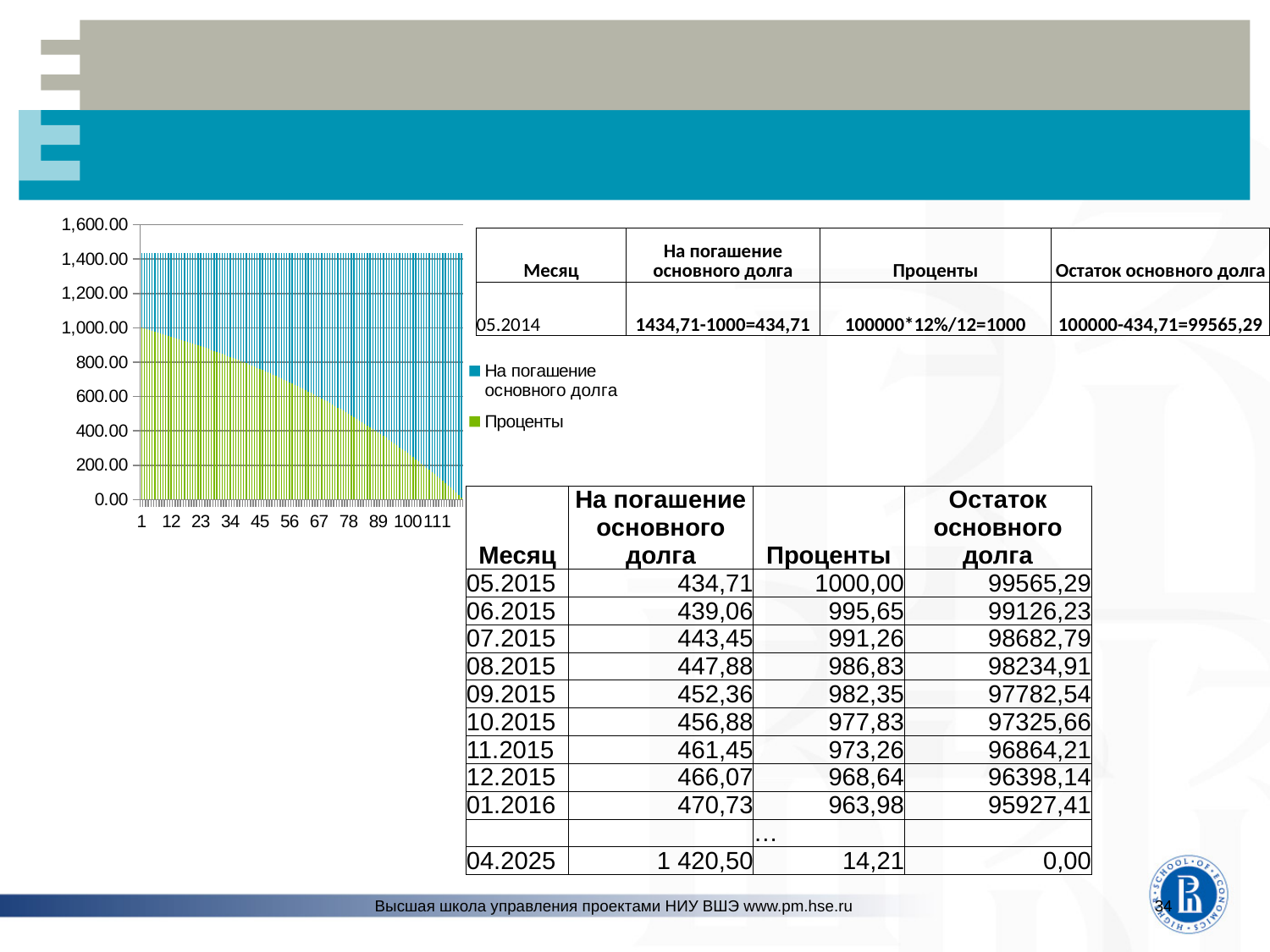
At month 111, which series has the larger value, Проценты or На погашение основного долга? На погашение основного долга Is the Проценты value at month 111 greater or less than 200? less Which series in the chart is shown in green? Проценты Is the total height of the stacked bar at month 111 greater or less than 1,000? greater Is the Проценты value at month 100 greater or less than 400? less Does the value of the На погашение основного долга series rise or fall as the month number increases along the x axis? rise Which series in the chart is shown in blue? На погашение основного долга Does the value of the Проценты series rise or fall as the month number increases along the x axis? fall What kind of chart is shown on the left of the slide? bar chart How many series does the chart legend list? 2